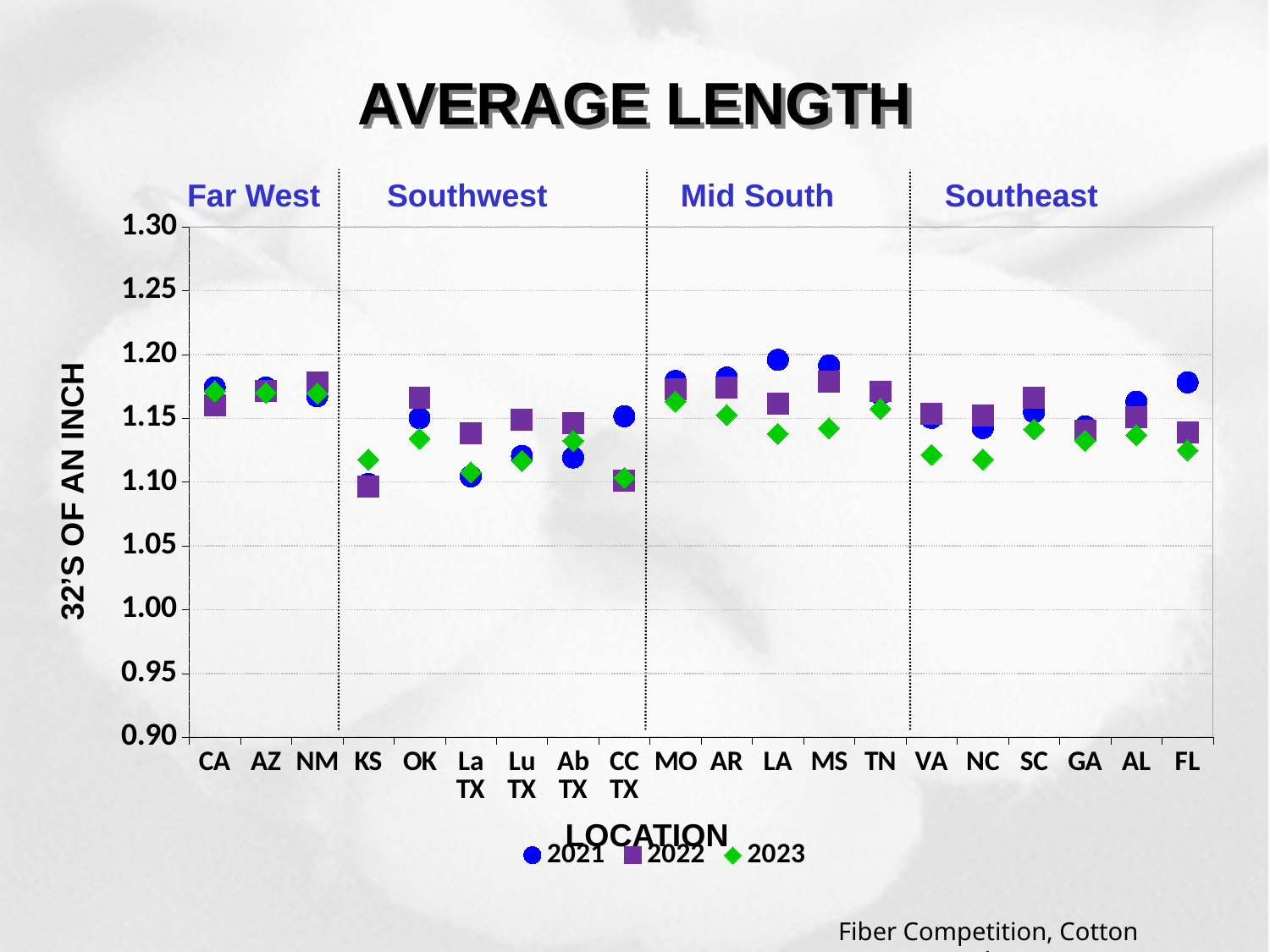
What is the label on the y axis? 32'S OF AN INCH What is the title of the chart? AVERAGE LENGTH How many locations are shown along the x axis? 20 Is the 2023 value for KS greater or less than 1.10? greater Is the 2023 value for NC greater or less than 1.15? less Which has the larger 2021 value, MO or CC TX? MO Is the 2021 value for LA greater or less than 1.15? greater For LA, which series has the larger value, 2021 or 2023? 2021 How many series does the legend list? 3 What kind of chart is shown on the slide? scatter chart